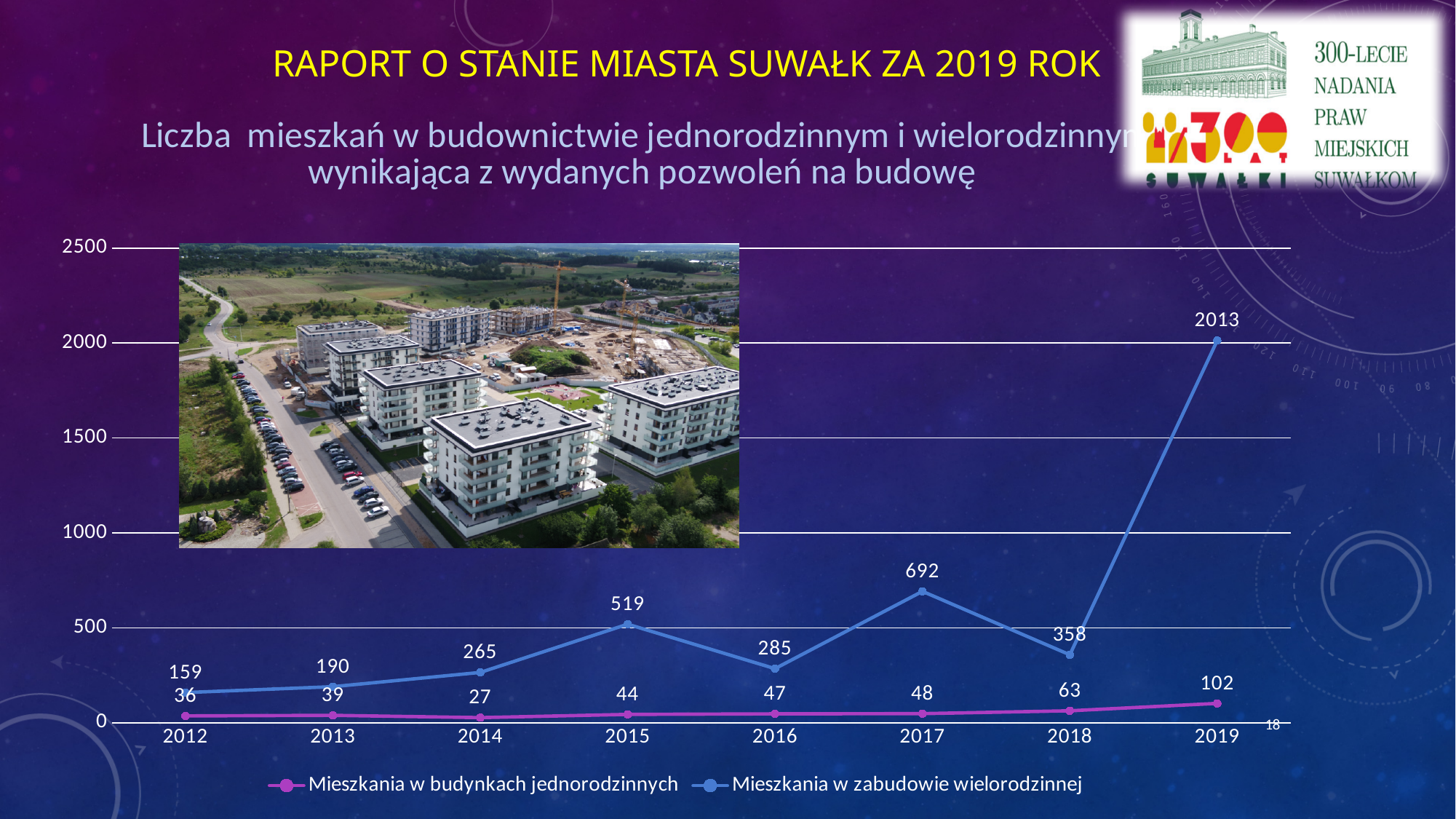
What is the difference between 'Mieszkania w zabudowie wielorodzinnej' in 2019 and 2018? 1655 Is the value for 'Mieszkania w zabudowie wielorodzinnej' in 2017 greater or less than 500? greater What type of chart is shown on the slide? line chart In which year is 'Mieszkania w budynkach jednorodzinnych' lowest? 2014 In which year is 'Mieszkania w zabudowie wielorodzinnej' highest? 2019 Which colour is used for the 'Mieszkania w budynkach jednorodzinnych' series? magenta How many series does the legend list? 2 What is the value for 'Mieszkania w budynkach jednorodzinnych' in 2014? 27 How many years are plotted on the x axis? 8 Which is larger: 'Mieszkania w zabudowie wielorodzinnej' in 2015 or in 2016? 2015 What is the value for 'Mieszkania w zabudowie wielorodzinnej' in 2017? 692 What is the value for 'Mieszkania w zabudowie wielorodzinnej' in 2019? 2013